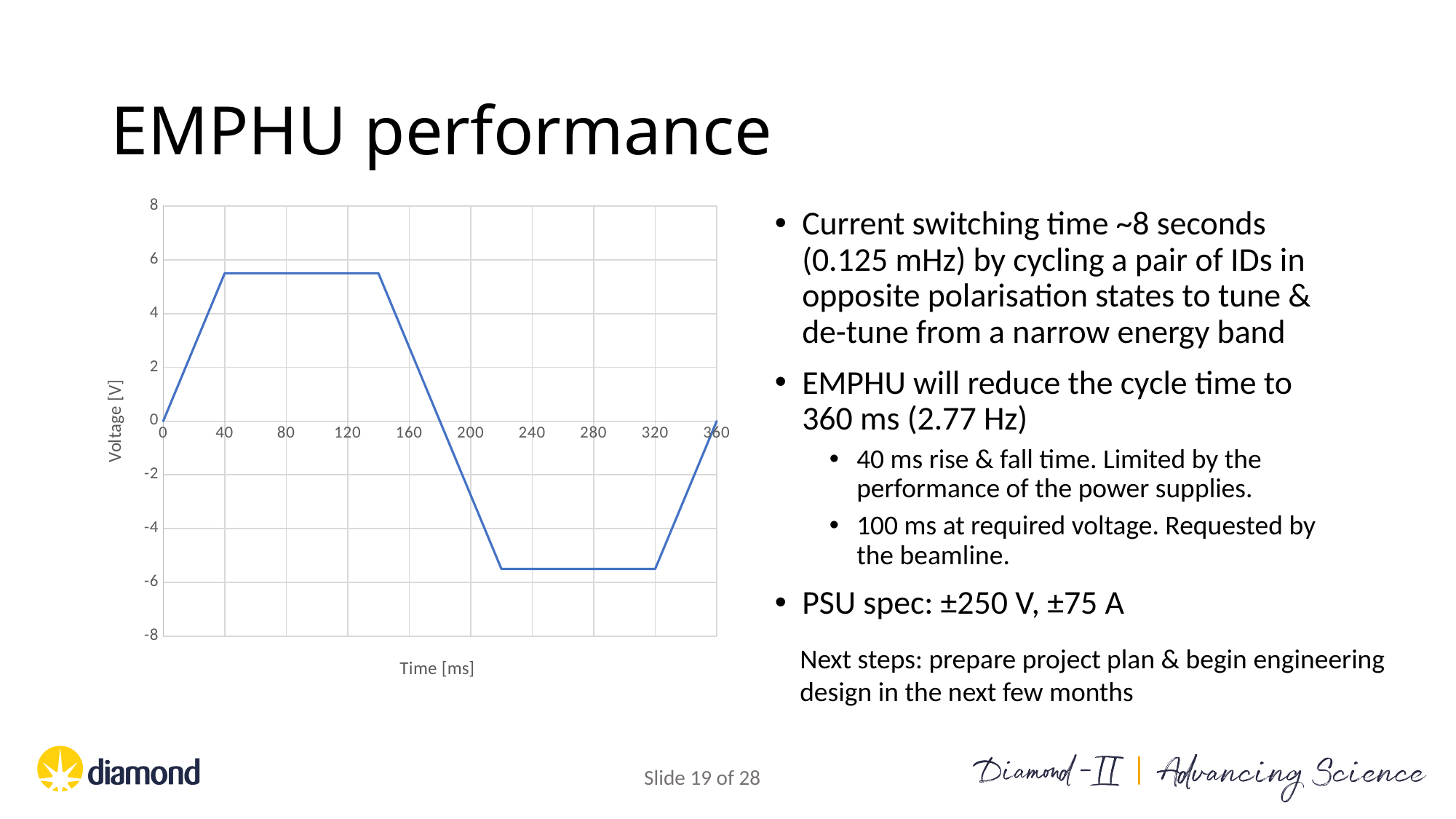
Which is larger, the voltage at 80 ms or the voltage at 280 ms? 80 ms What is the voltage at time 360 ms? 0 Does the voltage rise or fall between 0 ms and 40 ms? rise What is the voltage at time 0 ms? 0 What is the label of the vertical axis of the chart? Voltage [V] What kind of chart is shown on the slide? line chart Is the voltage at 120 ms greater or less than 6? less Does the voltage rise or fall between 160 ms and 200 ms? fall What is the label of the horizontal axis of the chart? Time [ms] Is the voltage at 80 ms greater or less than 4? greater Is the voltage at 280 ms greater or less than -4? less